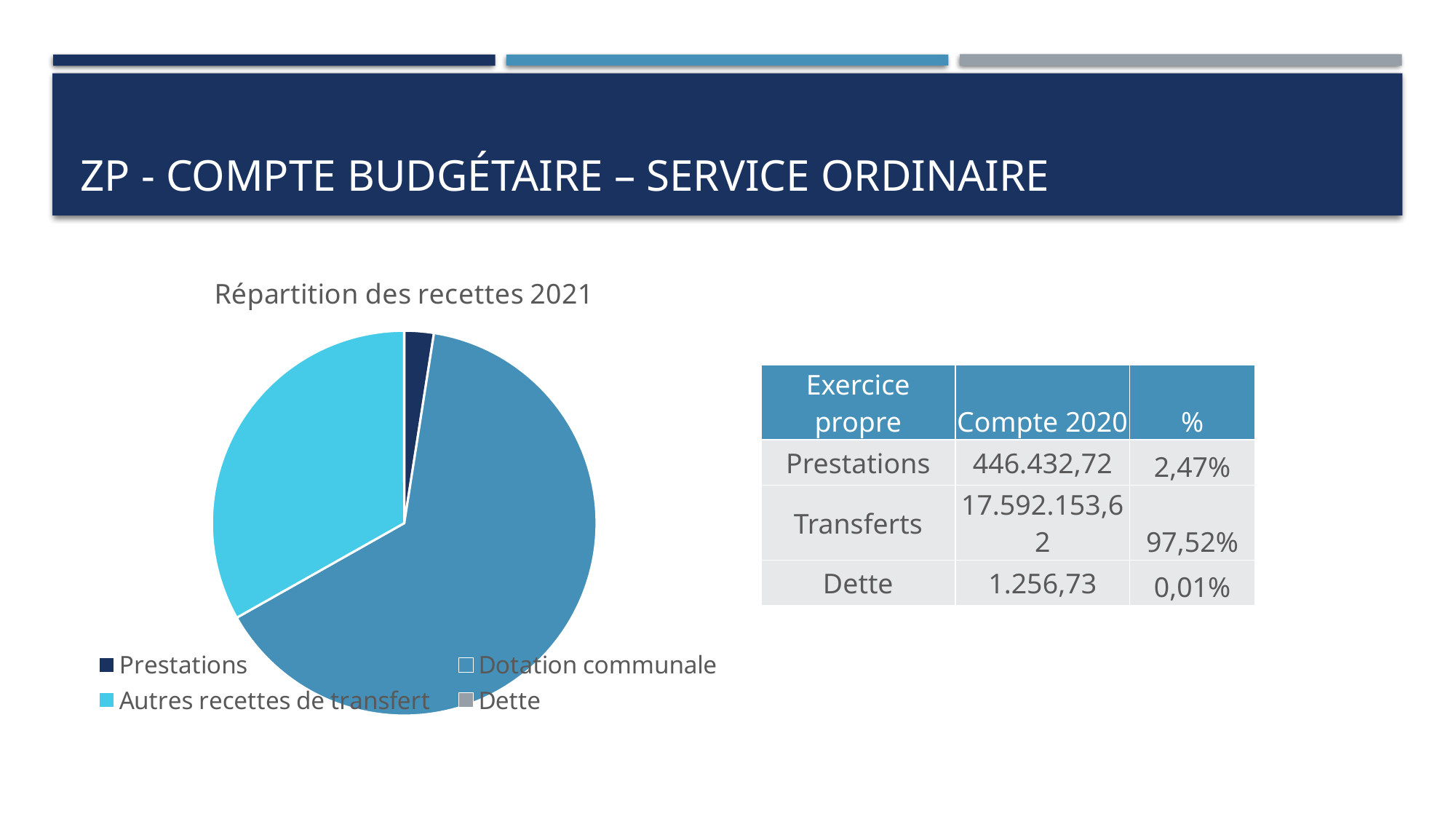
How many categories does the legend of the pie chart list? 4 Which category has the largest slice in the pie chart? Dotation communale What is the title of the pie chart? Répartition des recettes 2021 Which slice is larger in the pie chart, Dotation communale or Autres recettes de transfert? Dotation communale What kind of chart is shown on the slide? pie chart Which slice is larger in the pie chart, Prestations or Dotation communale? Dotation communale Which category is shown in dark navy in the pie chart legend? Prestations Which slice is larger in the pie chart, Prestations or Autres recettes de transfert? Autres recettes de transfert Which category has the second-largest slice in the pie chart? Autres recettes de transfert